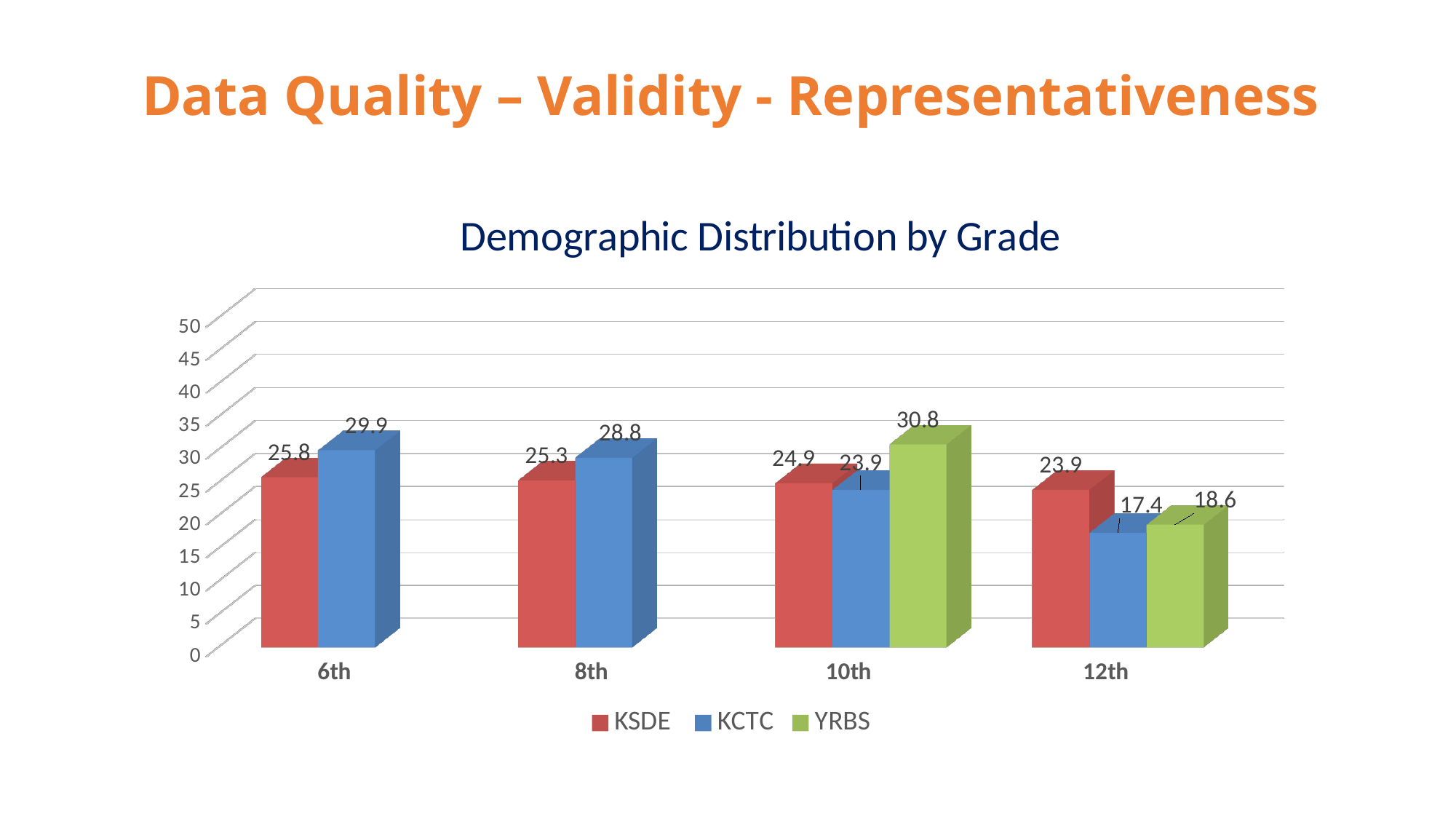
What is the KCTC value for 12th grade? 17.4 How many grade categories are shown on the x axis? 4 Which grade has the highest KCTC value? 6th What is the YRBS value for 10th grade? 30.8 For 12th grade, which is larger, the YRBS value or the KCTC value? YRBS What is the KCTC value for 8th grade? 28.8 What is the difference between the KCTC and KSDE values for 6th grade? 4.1 What kind of chart is shown on the slide? Bar chart What is the title of the chart? Demographic Distribution by Grade What is the KSDE value for 6th grade? 25.8 How many series does the legend list? 3 Which grade has the lowest KSDE value? 12th